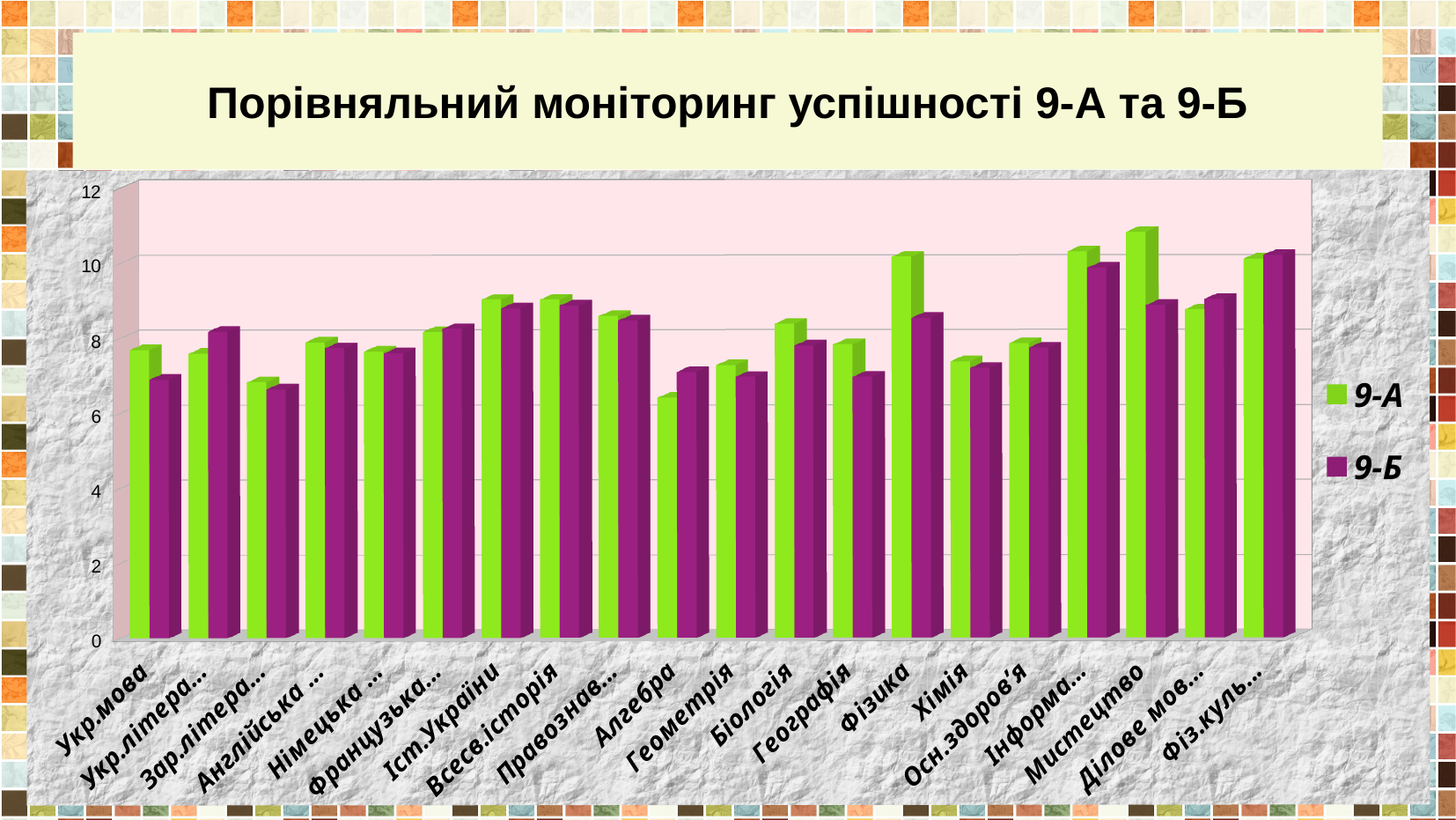
Is the 9-А value for Мистецтво greater or less than 10? greater For the 9-А series, which subject has the lowest value? Алгебра Which colour represents the 9-Б series? purple For Фізика, which series has the larger value, 9-А or 9-Б? 9-А What kind of chart is shown on the slide? bar chart For the 9-А series, which subject has the highest value? Мистецтво For Мистецтво, which series has the larger value, 9-А or 9-Б? 9-А What is the title of the chart? Порівняльний моніторинг успішності 9-А та 9-Б Is the 9-А value for Алгебра greater or less than 8? less For Алгебра, which series has the larger value, 9-А or 9-Б? 9-Б How many series does the legend list? 2 How many subject categories are shown on the x axis? 20